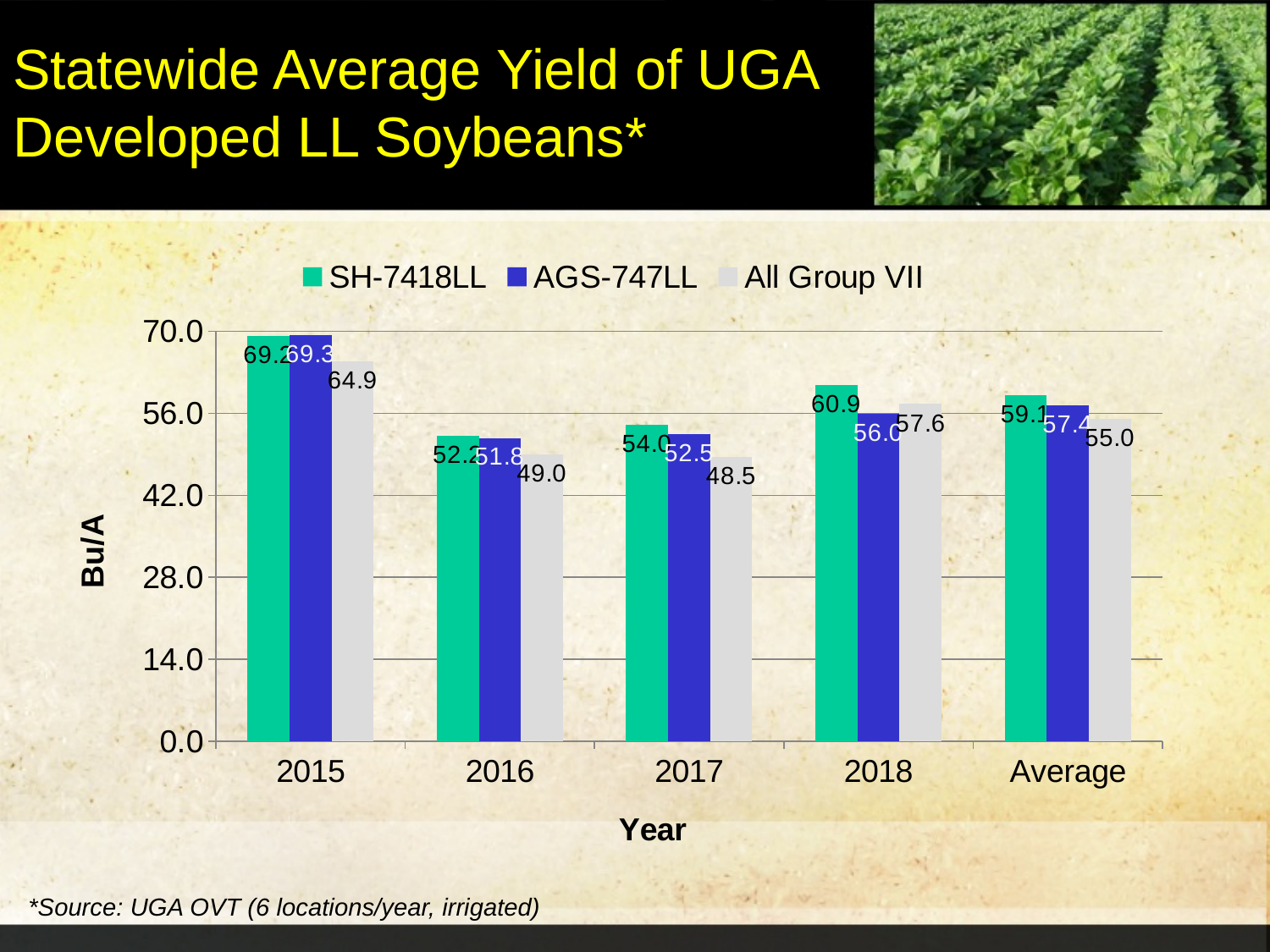
What is the value for SH-7418LL in 2018? 60.9 How many categories are shown on the x axis? 5 What is the value for AGS-747LL in 2017? 52.5 How many series does the legend list? 3 What kind of chart is shown on the slide? bar chart In 2016, which is larger: AGS-747LL or All Group VII? AGS-747LL What is the value for All Group VII in 2015? 64.9 In which year is the All Group VII yield lowest? 2017 What is the difference between SH-7418LL and All Group VII in 2018? 3.3 What is the Average value for All Group VII? 55.0 Is the value for SH-7418LL in 2017 greater or less than 42.0? greater In which year is the SH-7418LL yield highest? 2015